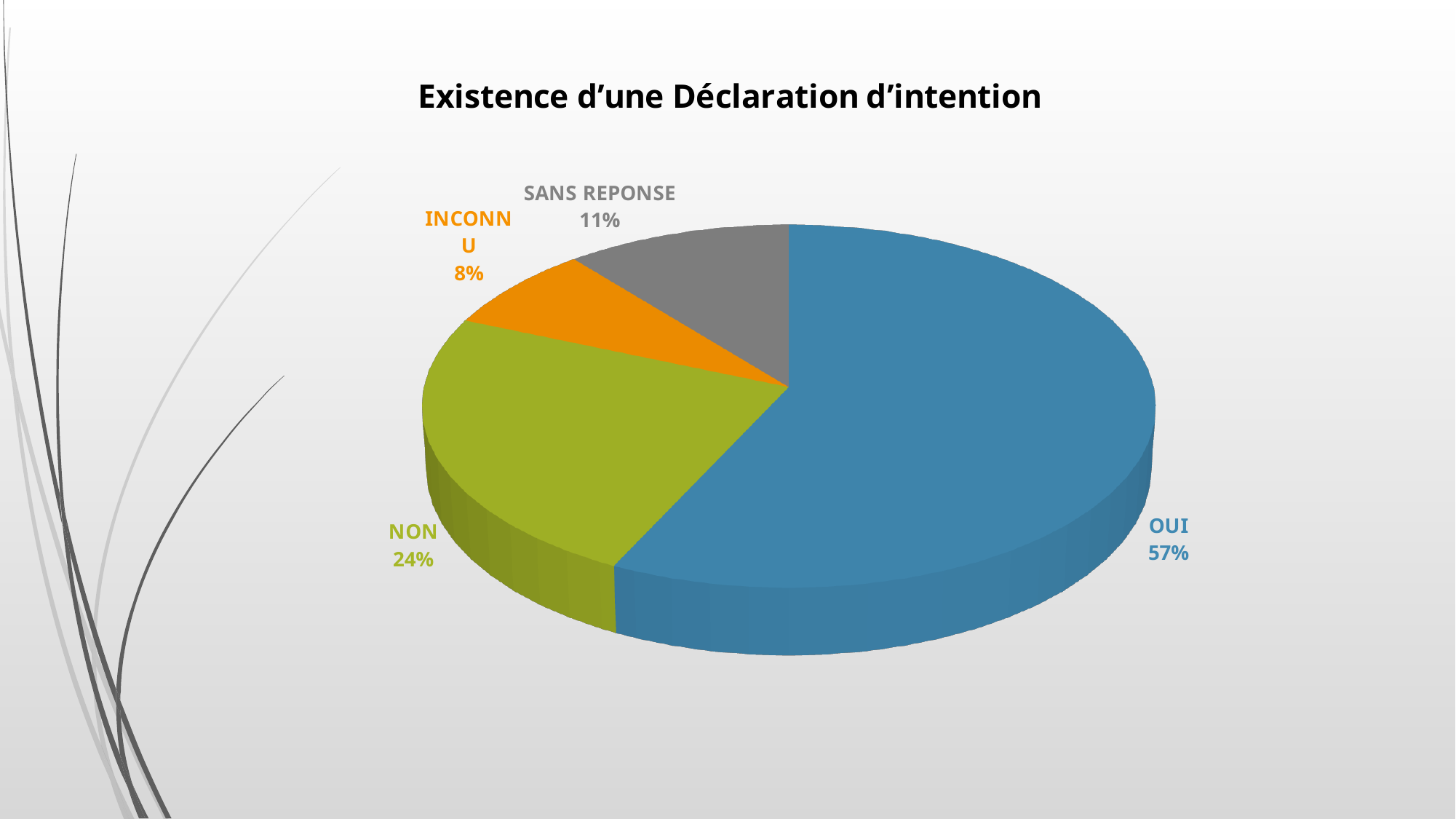
What kind of chart is shown on the slide? Pie chart Which category has the largest slice of the pie? OUI What share of the pie does NON represent? 24% What is the difference in percentage points between OUI and NON? 33 How many categories are shown in the pie chart? 4 Which category has the smallest slice of the pie? INCONNU Which is larger, the share for NON or the share for SANS REPONSE? NON What share of the pie does INCONNU represent? 8% What share of the pie does OUI represent? 57% What is the difference in percentage points between SANS REPONSE and INCONNU? 3 What is the title of the chart? Existence d’une Déclaration d’intention